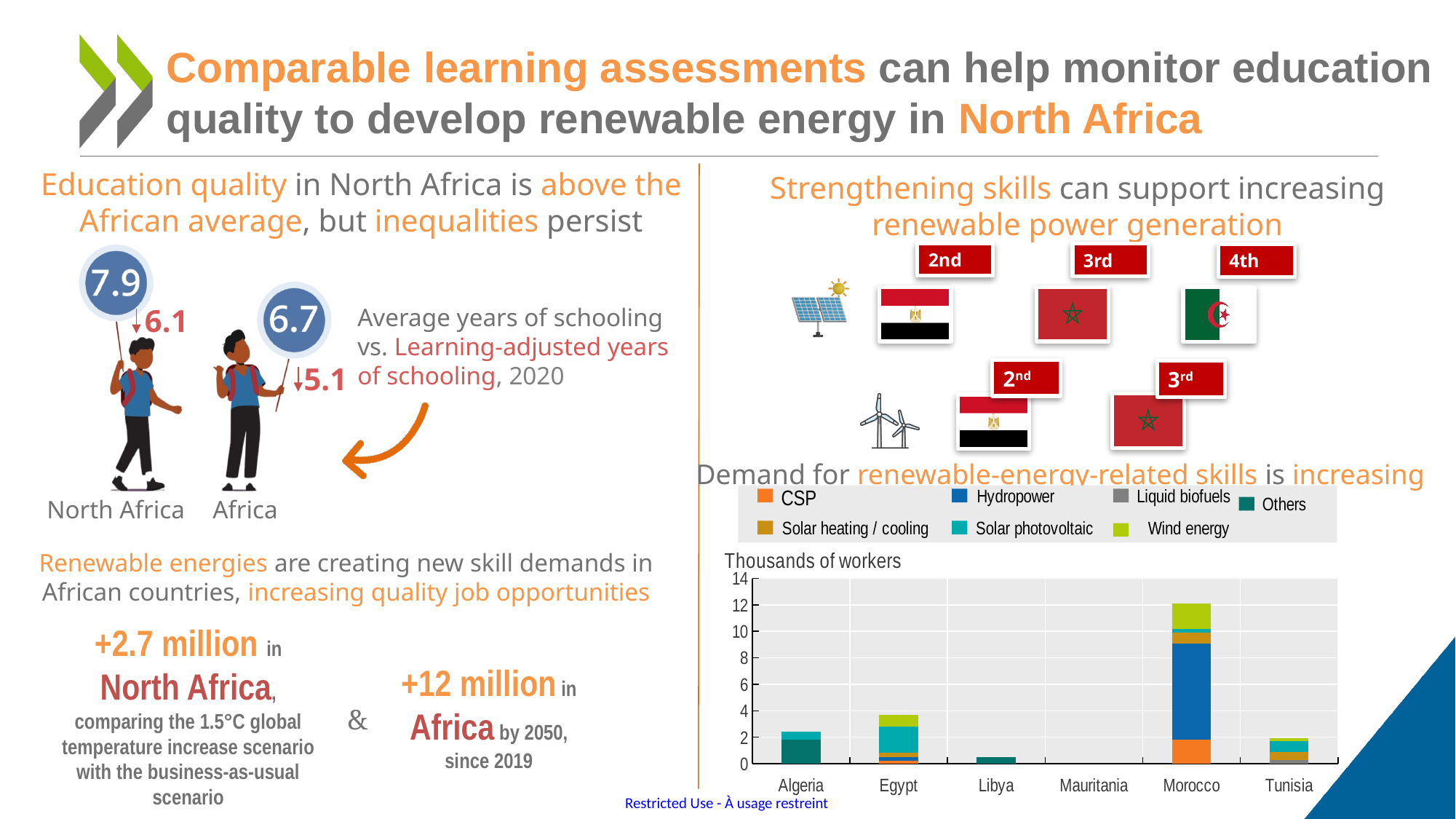
What unit is given for the y axis of the bar chart? Thousands of workers Is the total stacked value for Algeria greater or less than 4? less Which has a larger total stacked bar, Morocco or Egypt? Morocco Is the total stacked value for Egypt greater or less than 6? less Which series in the bar chart's legend is shown in dark blue? Hydropower What kind of chart is shown at the bottom right of the slide? stacked bar chart Is the total stacked value for Morocco greater or less than 10? greater How many series does the legend of the bar chart list? 7 Which has a larger total stacked bar, Egypt or Libya? Egypt How many countries are shown on the x axis of the bar chart? 6 Which country has the smallest stacked bar in the chart? Mauritania Which country has the tallest stacked bar in the chart? Morocco